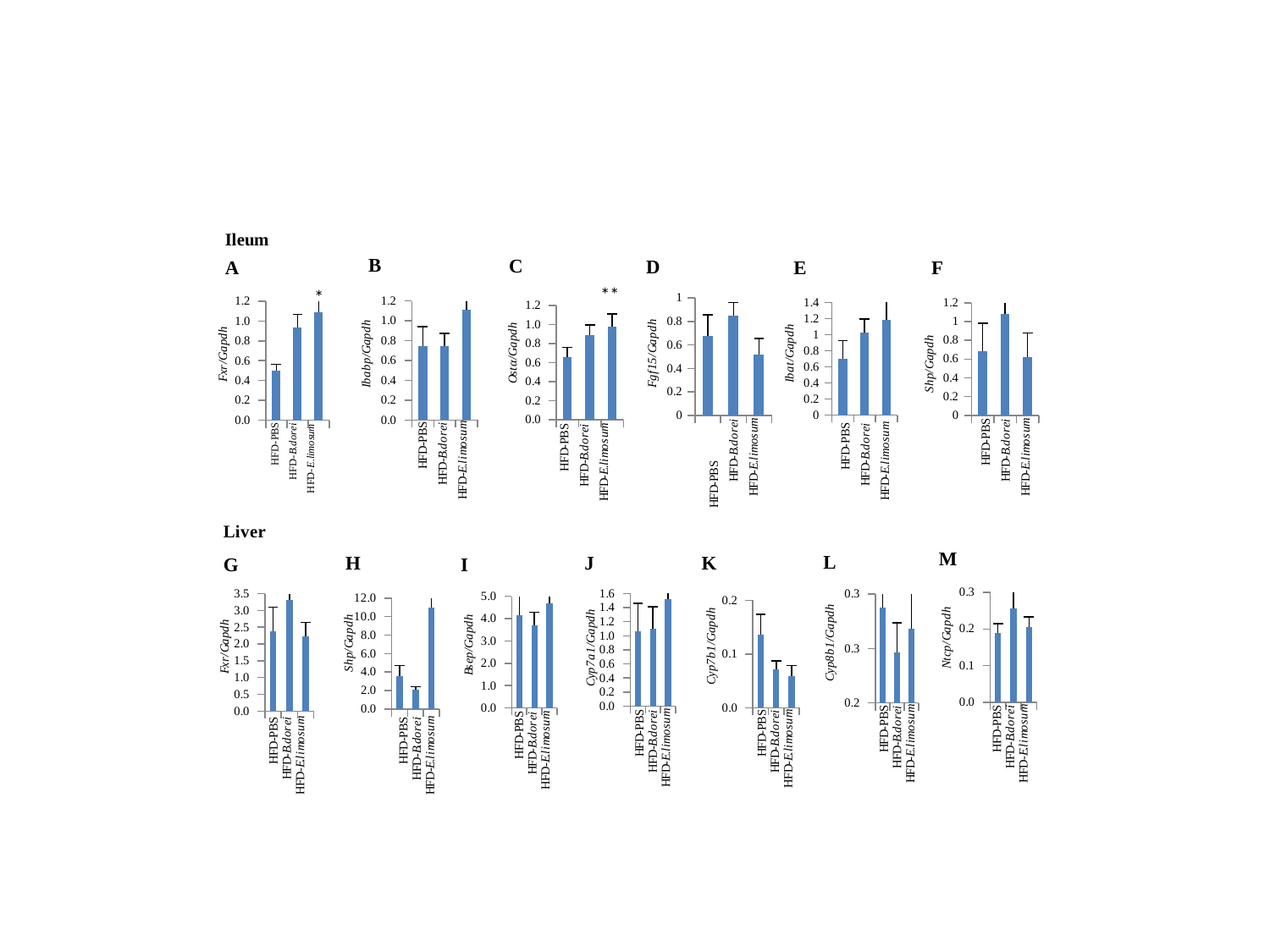
In chart C (Osta/Gapdh), do the values rise or fall from HFD-PBS to HFD-E.limosum? rise In chart A (Fxr/Gapdh, Ileum), is the value for HFD-PBS greater or less than 0.6? less In chart G (Fxr/Gapdh, Liver), which is larger, the value for HFD-B.dorei or HFD-PBS? HFD-B.dorei In chart D (Fgf15/Gapdh), which group has the lowest value? HFD-E.limosum In chart A (Fxr/Gapdh, Ileum), which group has the highest value? HFD-E.limosum What kind of chart is chart J (Cyp7a1/Gapdh)? bar chart In chart K (Cyp7b1/Gapdh), is the value for HFD-PBS greater or less than 0.1? greater How many charts are shown under the 'Liver' heading? 7 In chart K (Cyp7b1/Gapdh), which group has the highest value? HFD-PBS In chart H (Shp/Gapdh, Liver), which group has the lowest value? HFD-B.dorei How many groups (bars) are shown in chart M (Ntcp/Gapdh)? 3 In chart H (Shp/Gapdh, Liver), is the value for HFD-E.limosum greater or less than 10.0? greater